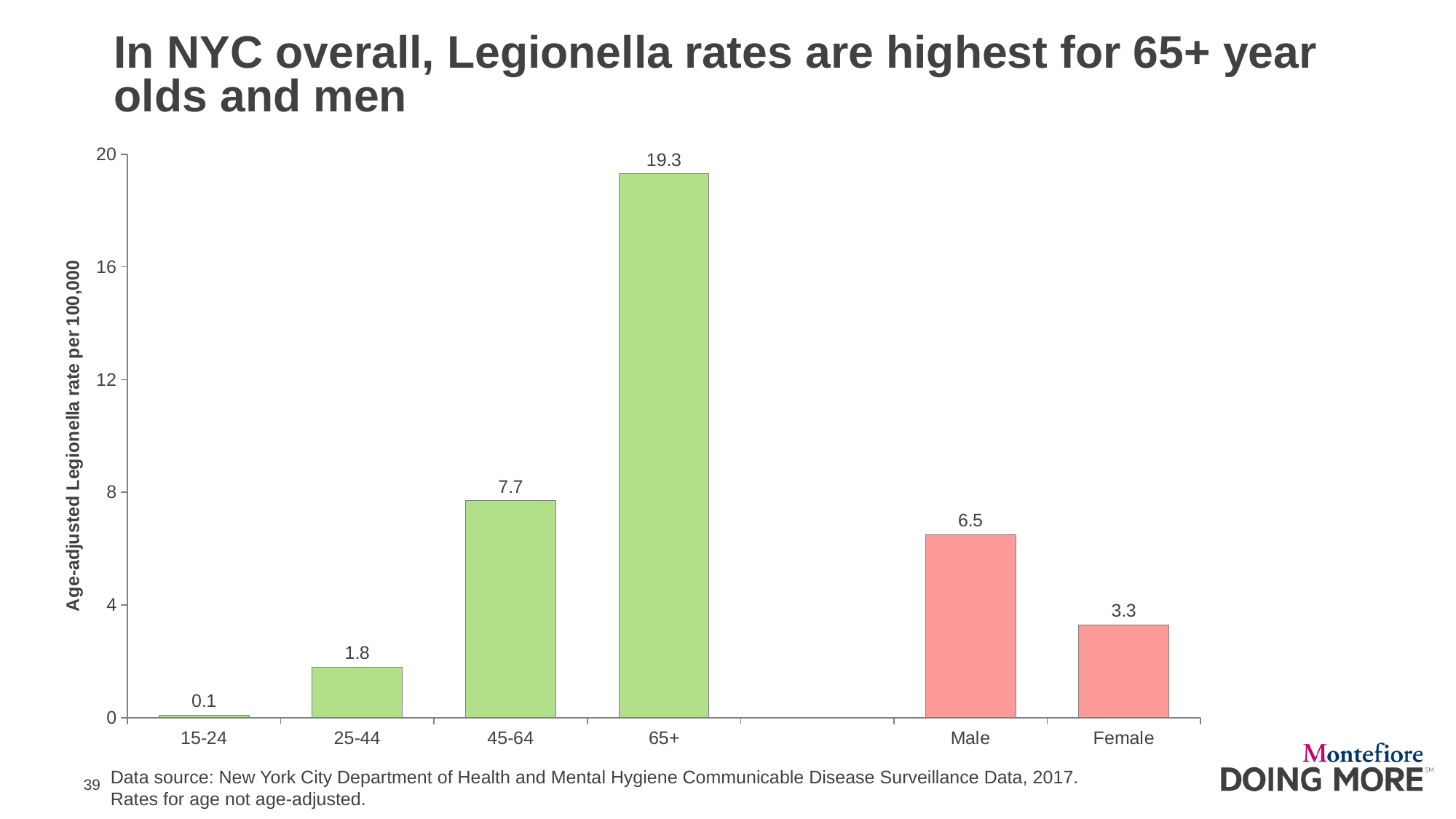
What is the Legionella rate for the 25-44 age group? 1.8 What kind of chart is shown on the slide? bar chart Which category has the lowest Legionella rate? 15-24 What is the label of the vertical axis? Age-adjusted Legionella rate per 100,000 What is the difference between the Legionella rates for males and females? 3.2 What is the Legionella rate for the 65+ age group? 19.3 Is the value for the 65+ age group greater or less than 16? greater Which category has the highest Legionella rate? 65+ Which has a higher Legionella rate, the 45-64 age group or males? 45-64 What is the Legionella rate for males? 6.5 What is the difference between the Legionella rates for the 65+ and 45-64 age groups? 11.6 How many categories are shown on the x axis? 6